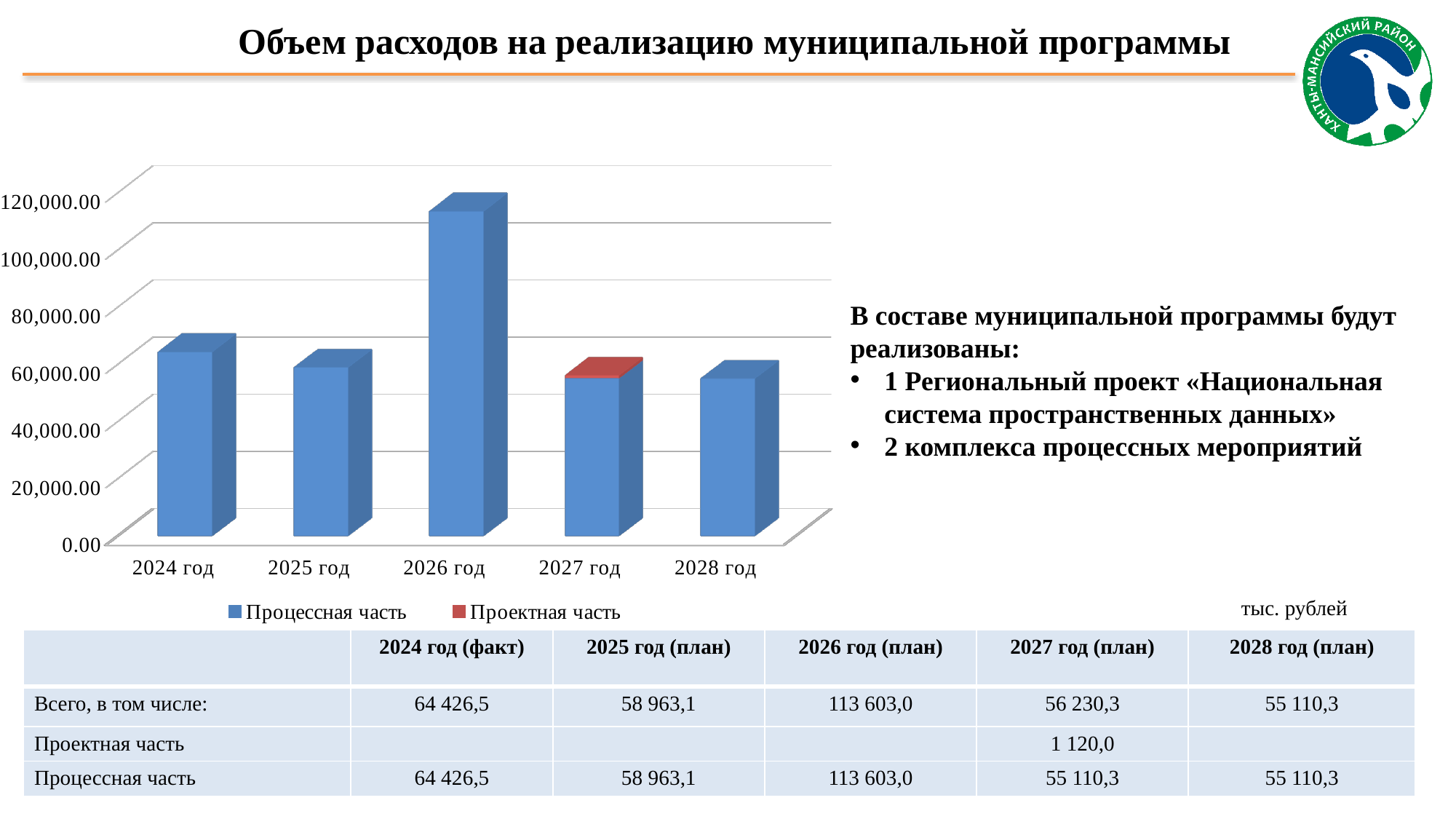
Which is larger, the bar for 2024 год or the bar for 2025 год? 2024 год How many years are shown on the x axis of the chart? 5 What kind of chart is shown on the slide? bar chart What is the difference between Процессная часть for 2026 год and 2024 год? 49 176,5 Is the value for 2026 год greater or less than 100,000.00? greater Which year's bar includes a Проектная часть segment? 2027 год What is the value of Процессная часть for 2026 год? 113 603,0 What colour represents Проектная часть in the chart legend? red What is the total of the stacked bar for 2027 год? 56 230,3 How many series does the chart legend list? 2 What is the value of Проектная часть for 2027 год? 1 120,0 Which year has the highest bar in the chart? 2026 год